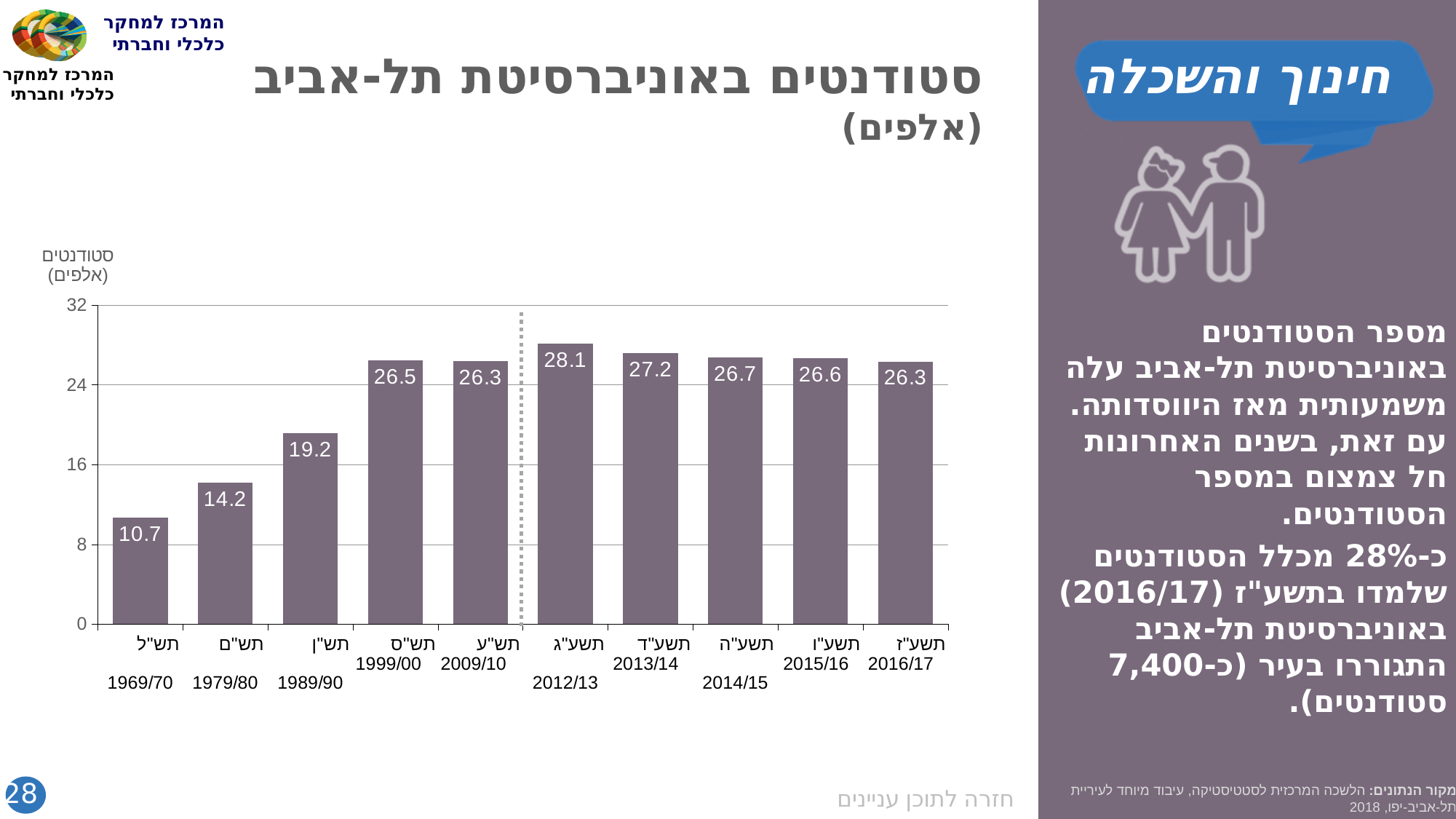
Which is larger, the value for 1999/00 or the value for 2013/14? 2013/14 Do the values rise or fall from 1969/70 to 1999/00? rise What is the value for 2012/13? 28.1 What is the value for 1989/90? 19.2 What is the difference between the values for 2012/13 and 2016/17? 1.8 How many bars are shown in the chart? 10 What is the value for 1969/70? 10.7 What is the value for 2016/17? 26.3 Which year has the highest value? 2012/13 What is the difference between the values for 1979/80 and 1969/70? 3.5 What kind of chart is shown on the slide? bar chart Which year has the lowest value? 1969/70